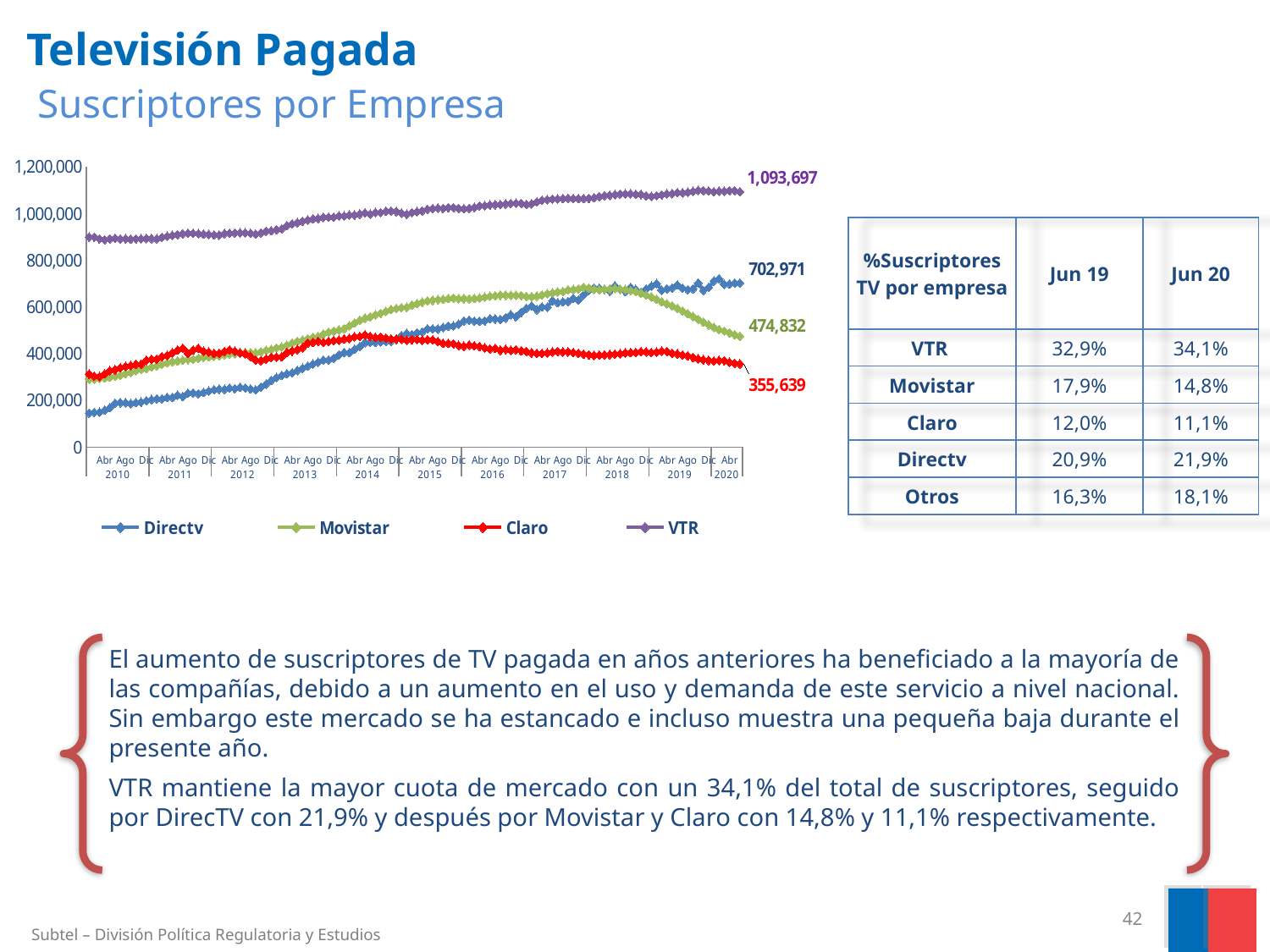
What is the difference between the final labelled values of Movistar and Claro? 119,193 What is the difference between the final labelled values of VTR and Directv? 390,726 At the end of the chart, which has more subscribers, Directv or Movistar? Directv How many series does the chart legend list? 4 Does the VTR line generally rise or fall from 2010 to 2020? rise What is the final labelled value for Directv on the chart? 702,971 Which company has the highest number of subscribers at the end of the chart (Abr 2020)? VTR What is the final labelled value for VTR on the chart? 1,093,697 What kind of chart is shown on the slide? line chart What is the final labelled value for Claro on the chart? 355,639 Which company has the lowest number of subscribers at the end of the chart (Abr 2020)? Claro Is the value for Directv at the start of 2010 greater or less than 200,000? less